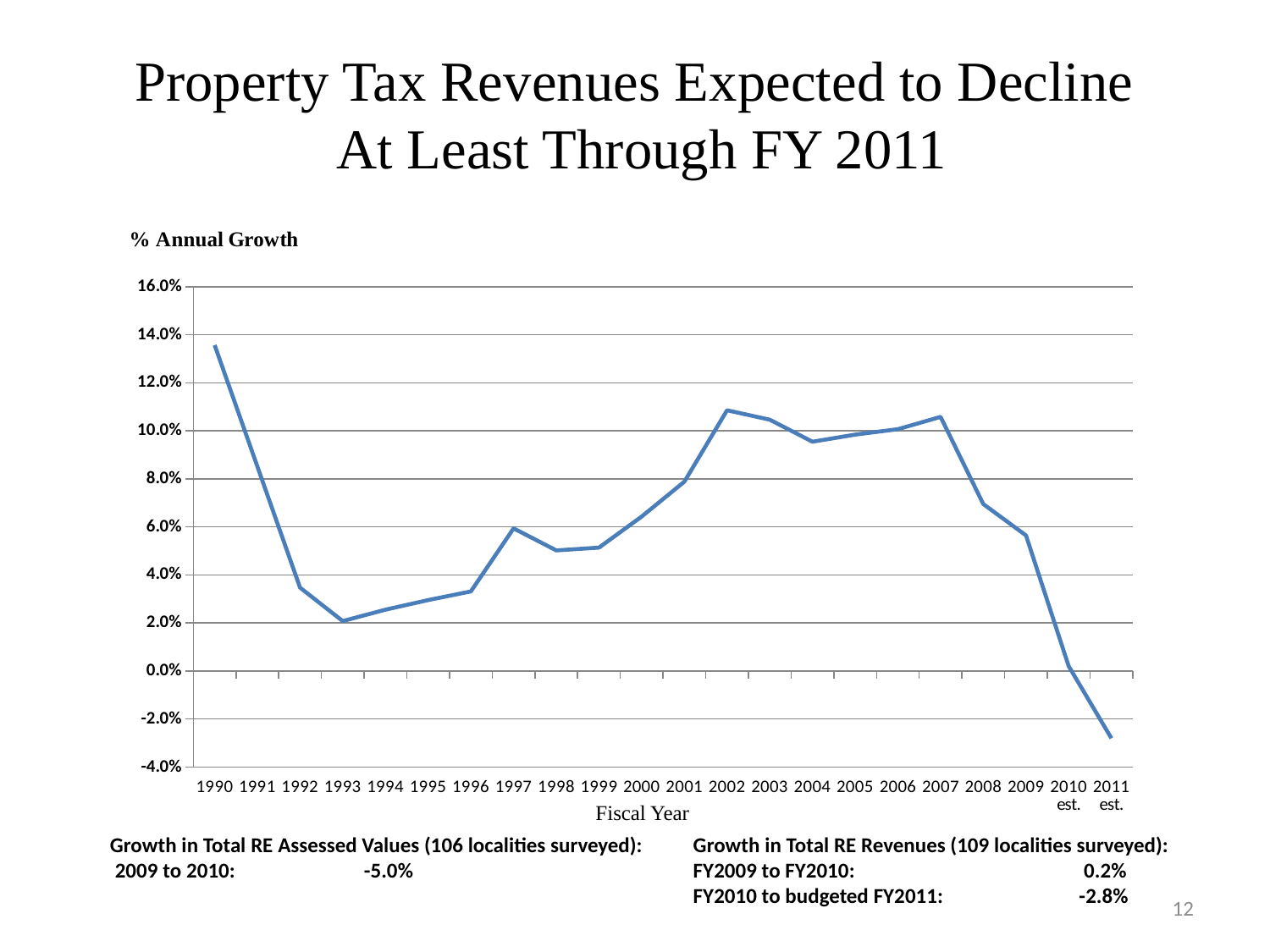
Which fiscal year has the lowest % annual growth on the chart? 2011 est. Is the value for 2002 greater or less than 10.0%? greater Is the value for 2009 greater or less than 8.0%? less Which is larger, the value for 1993 or the value for 1997? 1997 What is the title of the x axis of the chart? Fiscal Year Is the value for 1993 greater or less than 4.0%? less What kind of chart is shown on the slide? line chart Which fiscal year has the highest % annual growth on the chart? 1990 Do the values rise or fall from 2007 to 2011 est.? fall How many fiscal years are plotted on the x axis of the chart? 22